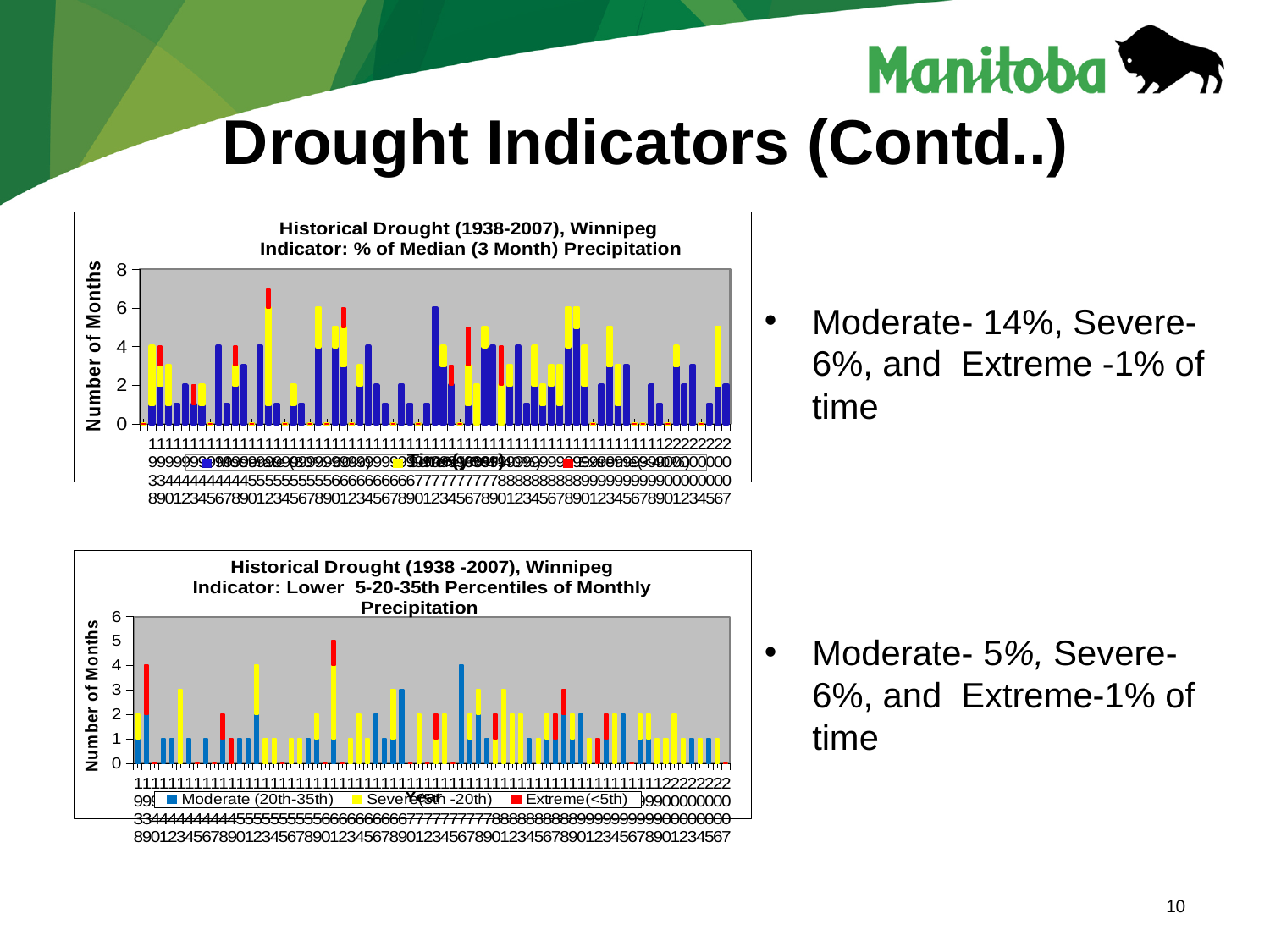
In the bottom chart, is the tallest stacked bar greater or less than 6 months? less In the top chart, what is the label on the vertical axis? Number of Months What kind of chart is the bottom chart, 'Historical Drought (1938-2007), Winnipeg, Indicator: Lower 5-20-35th Percentiles of Monthly Precipitation'? Bar chart In the top chart, is the tallest stacked bar greater or less than 6 months? greater What kind of chart is the top chart, 'Historical Drought (1938-2007), Winnipeg, Indicator: % of Median (3 Month) Precipitation'? Bar chart In the bottom chart, how many series does the legend list? 3 In the bottom chart, is the tallest stacked bar greater or less than 4 months? greater In the bottom chart, what are the three legend entries? Moderate (20th-35th), Severe (5th-20th), Extreme (<5th) Which chart has the higher maximum value on its vertical axis, the top chart or the bottom chart? The top chart